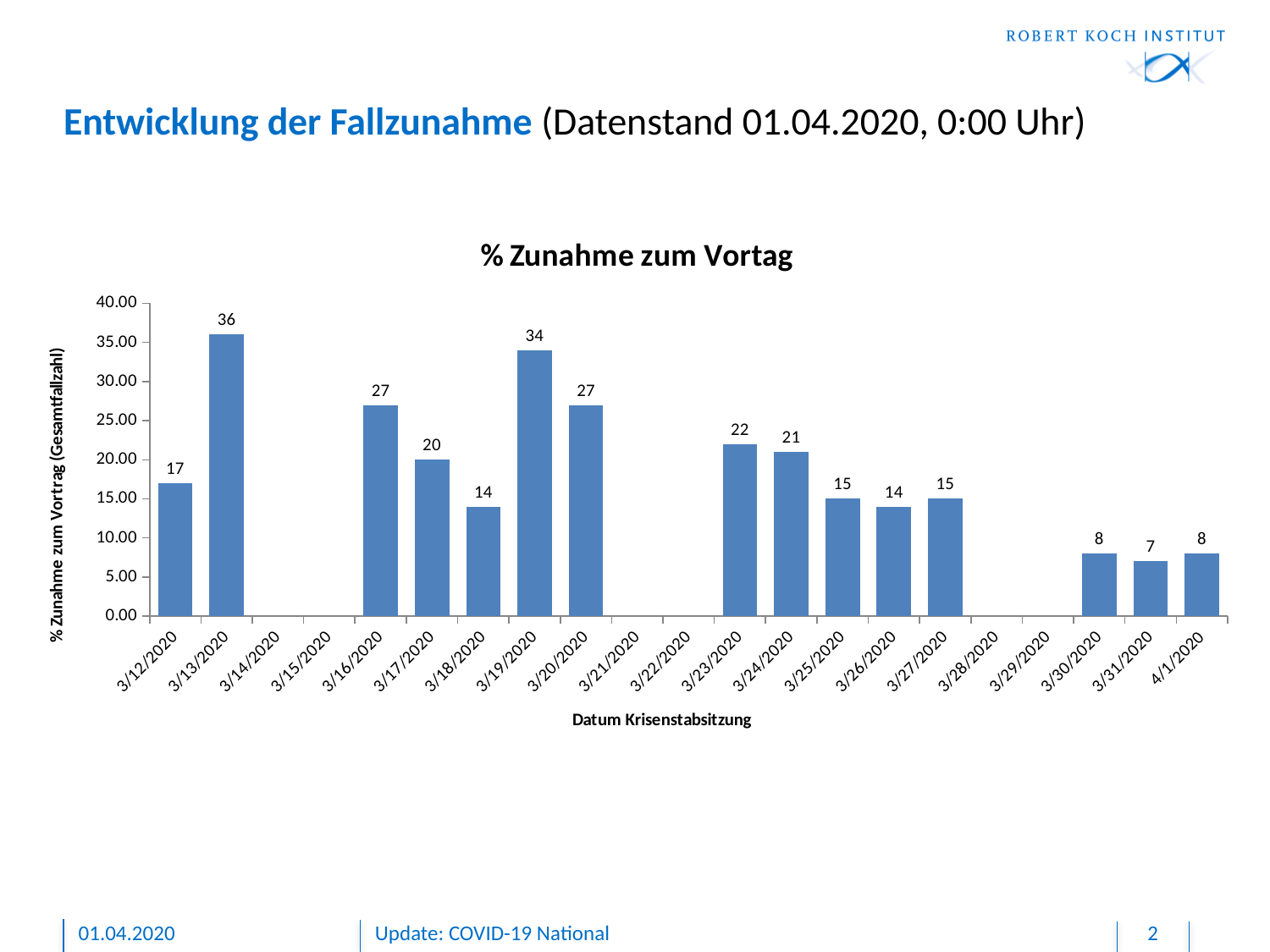
How many dates have a bar plotted in the chart? 15 What is the value for 3/31/2020? 7 Is the value for 3/16/2020 greater or less than 25.00? greater What is the value for 3/13/2020? 36 Which is larger, the value for 3/17/2020 or the value for 3/23/2020? 3/23/2020 What is the value for 3/19/2020? 34 What is the value for 3/24/2020? 21 What type of chart is shown on the slide? bar chart What is the title of the chart? % Zunahme zum Vortag What is the difference between the values for 3/13/2020 and 3/12/2020? 19 Which date has the highest value? 3/13/2020 Which date has the lowest value among the dates with a bar? 3/31/2020